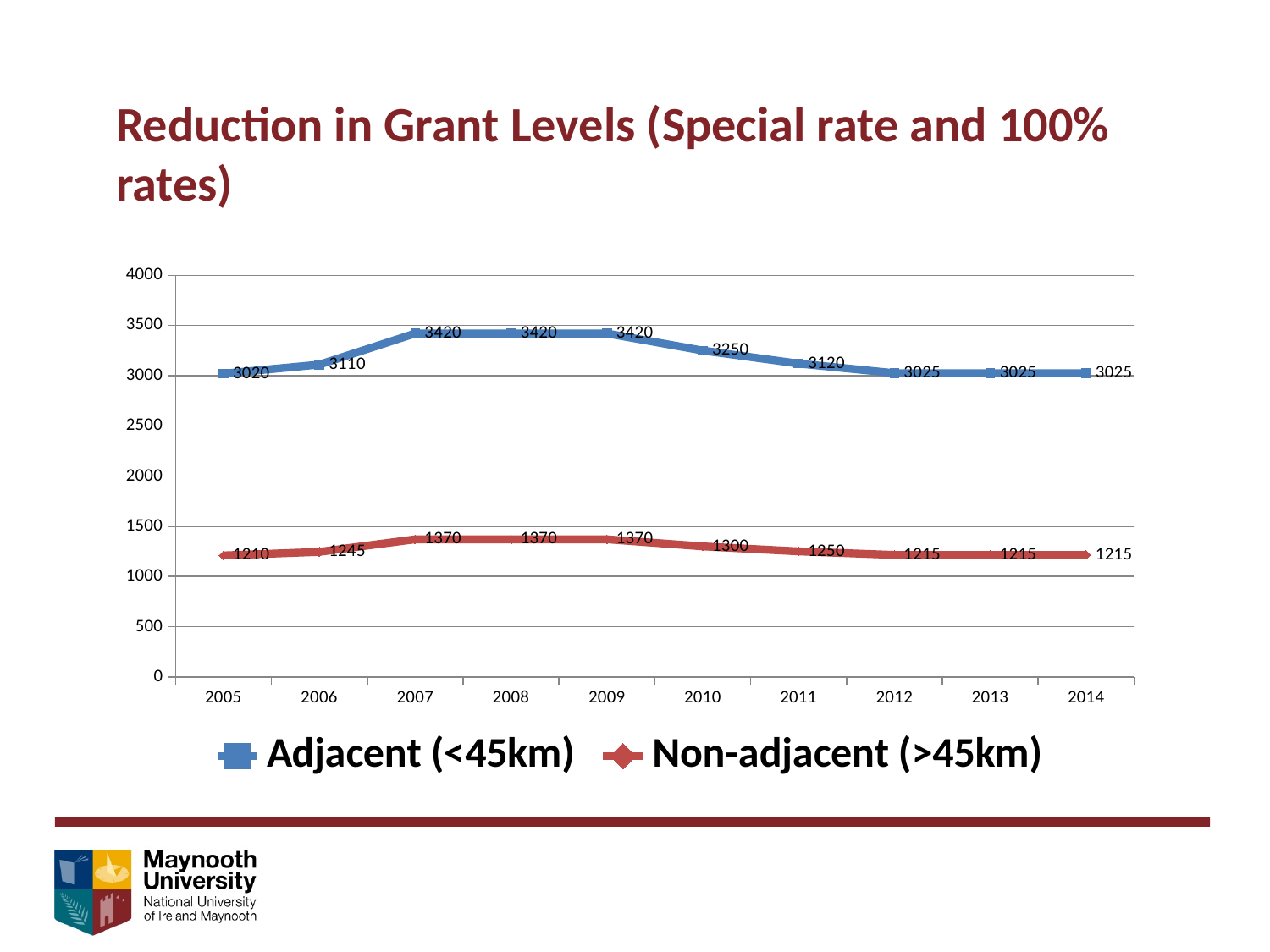
What is the value for Adjacent (<45km) in 2005? 3020 How many years are shown on the x axis? 10 Does the Adjacent (<45km) series rise or fall from 2009 to 2012? Fall By how much did the Adjacent (<45km) value fall from 2009 to 2012? 395 How many series does the legend list? 2 In which year is the Adjacent (<45km) value lowest? 2005 What is the difference between the Adjacent (<45km) and Non-adjacent (>45km) values in 2008? 2050 Which series has the higher value in 2014, Adjacent (<45km) or Non-adjacent (>45km)? Adjacent (<45km) What kind of chart is shown on the slide? Line chart What is the value for Adjacent (<45km) in 2011? 3120 In which year does the Non-adjacent (>45km) series first reach its highest value? 2007 What is the value for Non-adjacent (>45km) in 2010? 1300